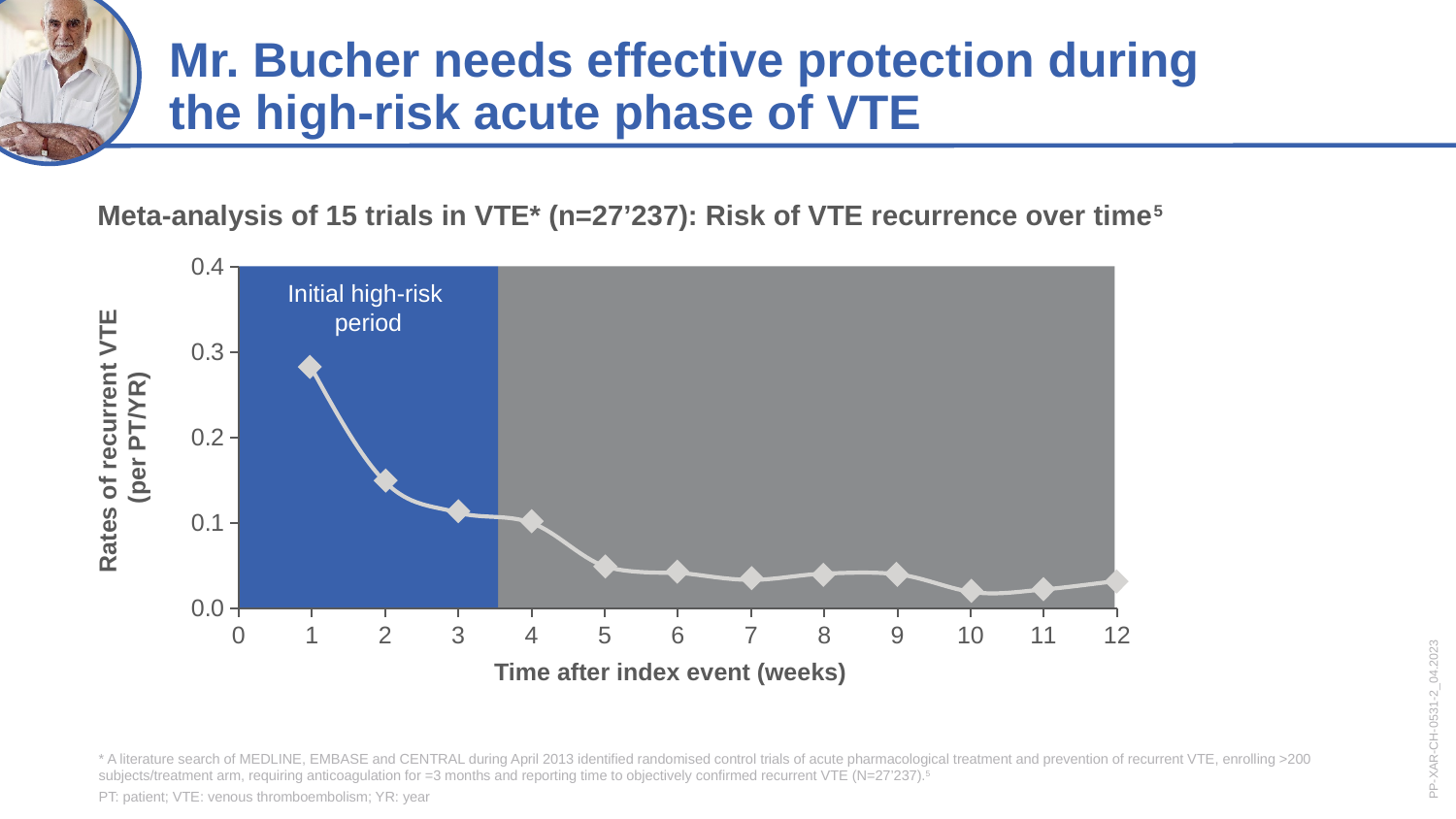
Do the rates of recurrent VTE rise or fall as time after the index event increases? fall Is the rate of recurrent VTE at week 1 greater or less than 0.3? less What kind of chart is shown on the slide? line chart What is the label on the x axis of the chart? Time after index event (weeks) Is the rate of recurrent VTE at week 12 greater or less than 0.1? less How many data points are plotted on the line? 12 Is the rate of recurrent VTE at week 2 greater or less than 0.1? greater What label is shown in the blue shaded region of the chart? Initial high-risk period At which week after the index event is the rate of recurrent VTE highest? 1 Which has a higher rate of recurrent VTE, week 2 or week 9? week 2